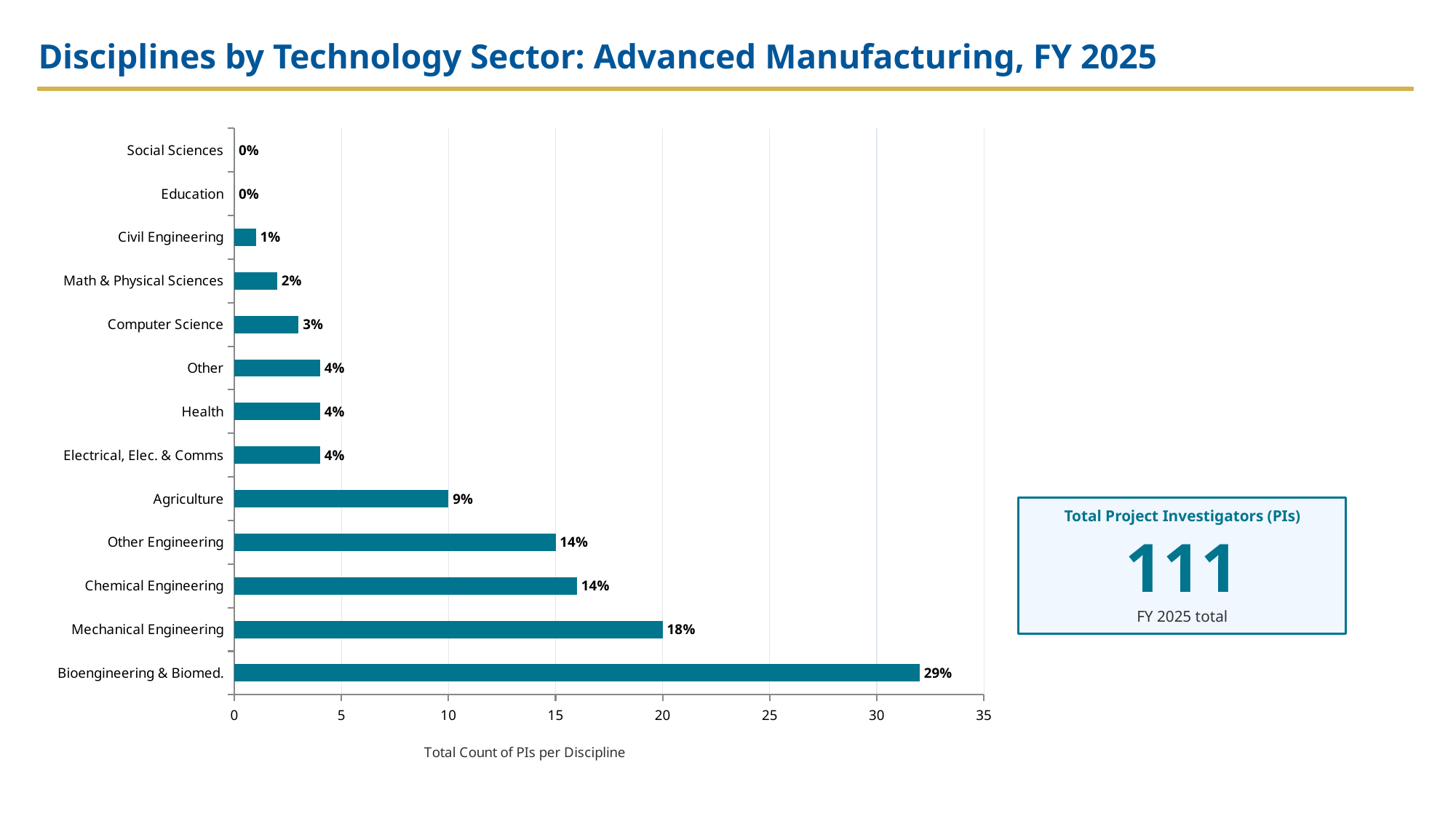
What percentage label is shown for Computer Science? 3% What is the total number of Project Investigators shown in the box on the slide? 111 Which discipline has the larger share of PIs, Mechanical Engineering or Agriculture? Mechanical Engineering How many disciplines are listed on the chart? 13 What percentage label is shown for Agriculture? 9% What percentage label is shown for Bioengineering & Biomed.? 29% Is the count of PIs for Chemical Engineering greater or less than 20? less Is the count of PIs for Bioengineering & Biomed. greater or less than 30? greater What is the difference in percentage points between Bioengineering & Biomed. and Mechanical Engineering? 11 What percentage label is shown for Mechanical Engineering? 18% What kind of chart is shown on the slide? Bar chart Which discipline has the highest share of PIs? Bioengineering & Biomed.